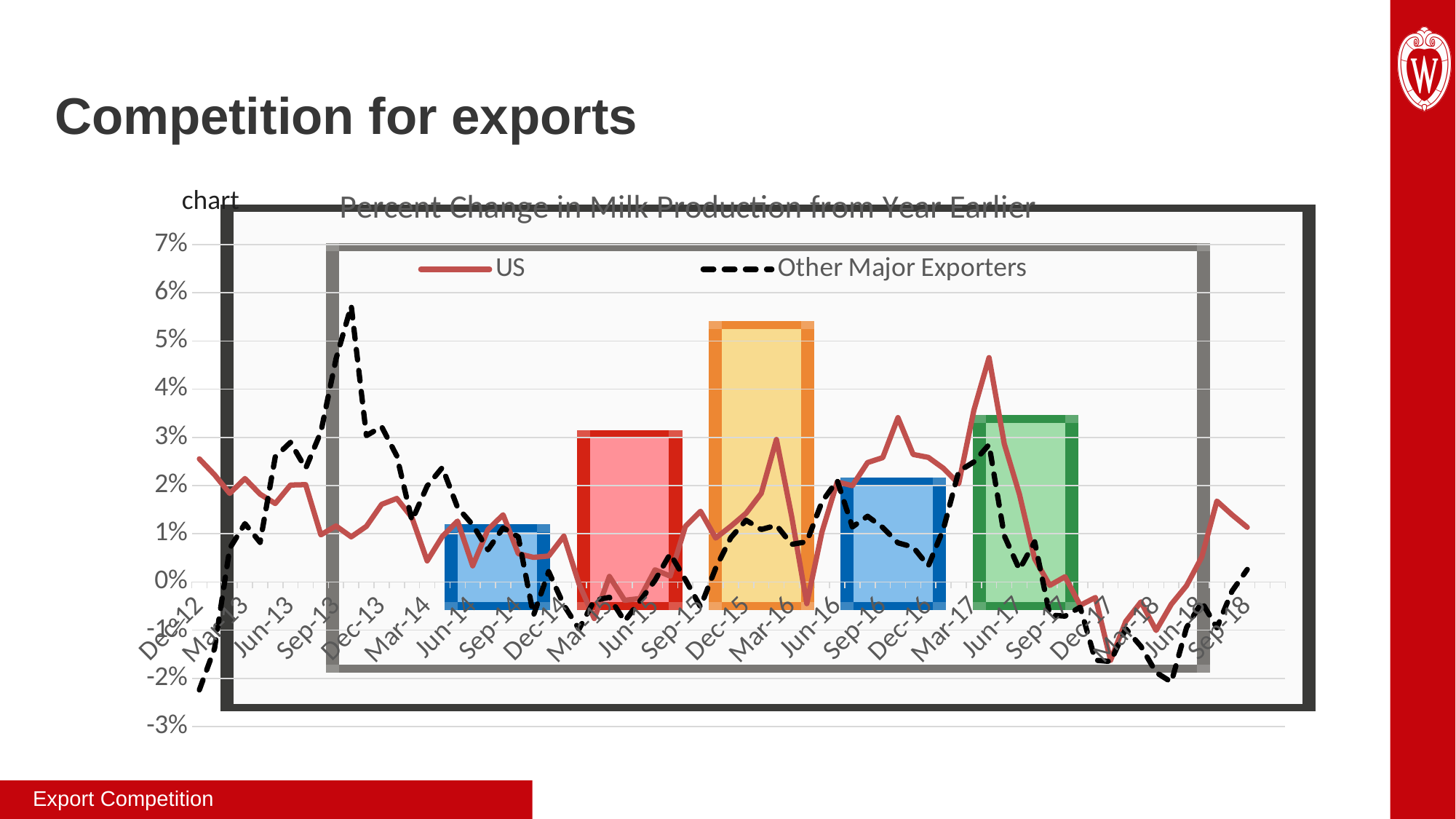
What is the title of the chart? Percent Change in Milk Production from Year Earlier What kind of chart is shown on the slide? line chart Which series is drawn with a dashed black line? Other Major Exporters Does the Other Major Exporters series rise or fall from Dec-12 to Sep-13? rise At Dec-12, which series has the larger value, US or Other Major Exporters? US Which series reaches the highest value anywhere on the chart? Other Major Exporters Is the value for US at Dec-12 greater or less than 2%? greater How many series does the chart legend list? 2 At Sep-13, which series has the larger value, US or Other Major Exporters? Other Major Exporters Is the value for Other Major Exporters at Dec-12 greater or less than 0%? less Is the peak value of Other Major Exporters around Sep-13 greater or less than 5%? greater